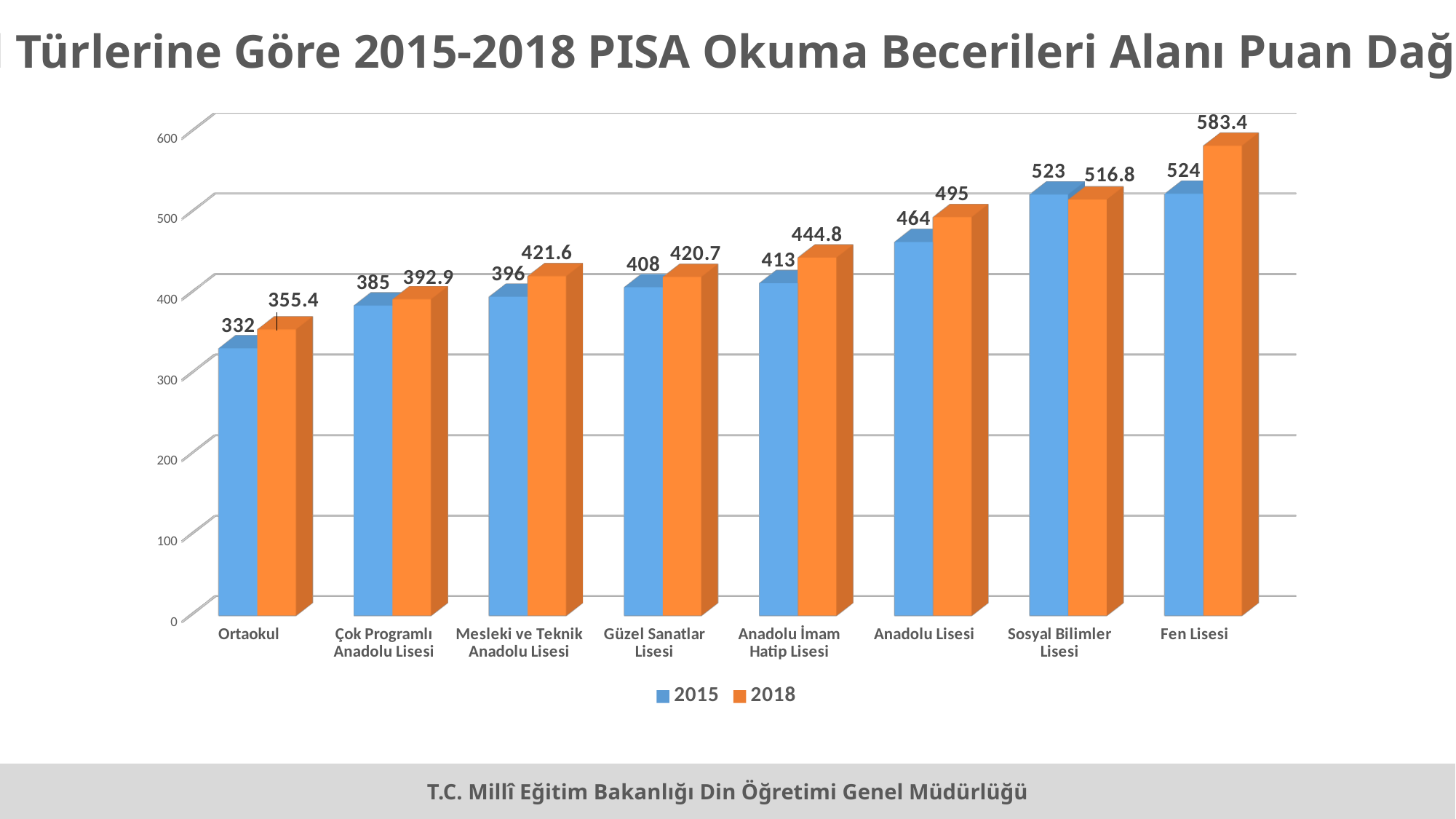
What is the 2018 value for Anadolu İmam Hatip Lisesi? 444.8 What is the 2018 value for Fen Lisesi? 583.4 How many categories are shown on the x axis? 8 What kind of chart is shown on the slide? bar chart What is the 2015 value for Ortaokul? 332 Which colour represents the 2018 series? orange How many series does the legend list? 2 Which is larger for Sosyal Bilimler Lisesi, the 2015 value or the 2018 value? 2015 What is the difference between the 2018 and 2015 values for Anadolu Lisesi? 31 Which category has the highest 2018 value? Fen Lisesi Which category has the lowest 2015 value? Ortaokul What is the 2015 value for Sosyal Bilimler Lisesi? 523